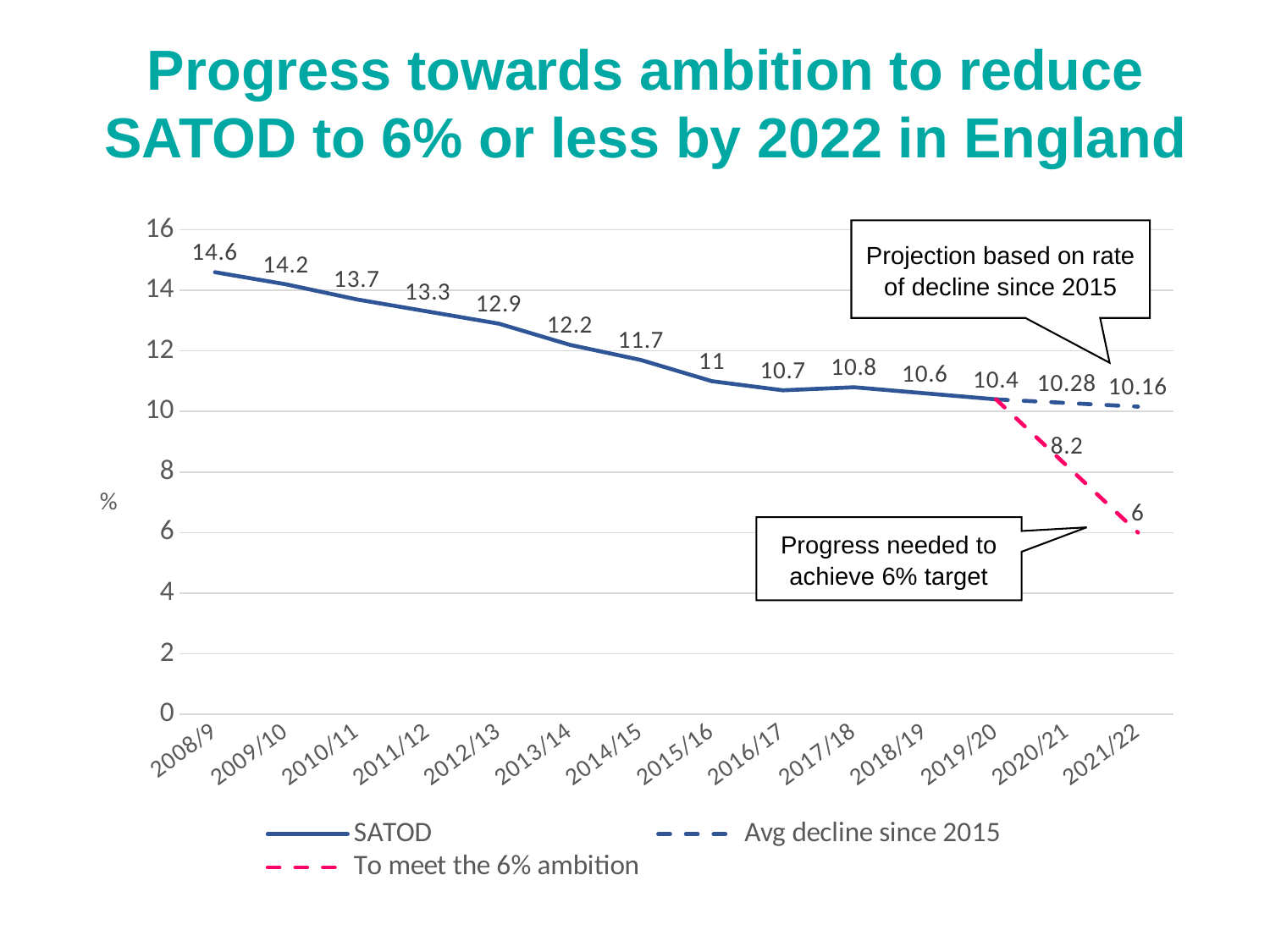
What is the difference between the SATOD values for 2008/9 and 2019/20? 4.2 What is the SATOD value for 2019/20? 10.4 How many series does the legend list? 3 What is the projected value for 2021/22 on the 'Avg decline since 2015' line? 10.16 How many years are shown on the x axis? 14 Which is larger, the SATOD value for 2016/17 or for 2017/18? 2017/18 Does the SATOD line generally rise or fall from 2008/9 to 2019/20? Fall What is the SATOD value for 2008/9? 14.6 Which year has the lowest SATOD value on the solid SATOD line? 2019/20 Which year has the highest SATOD value? 2008/9 What is the value for 2020/21 on the 'To meet the 6% ambition' line? 8.2 What type of chart is shown on the slide? Line chart